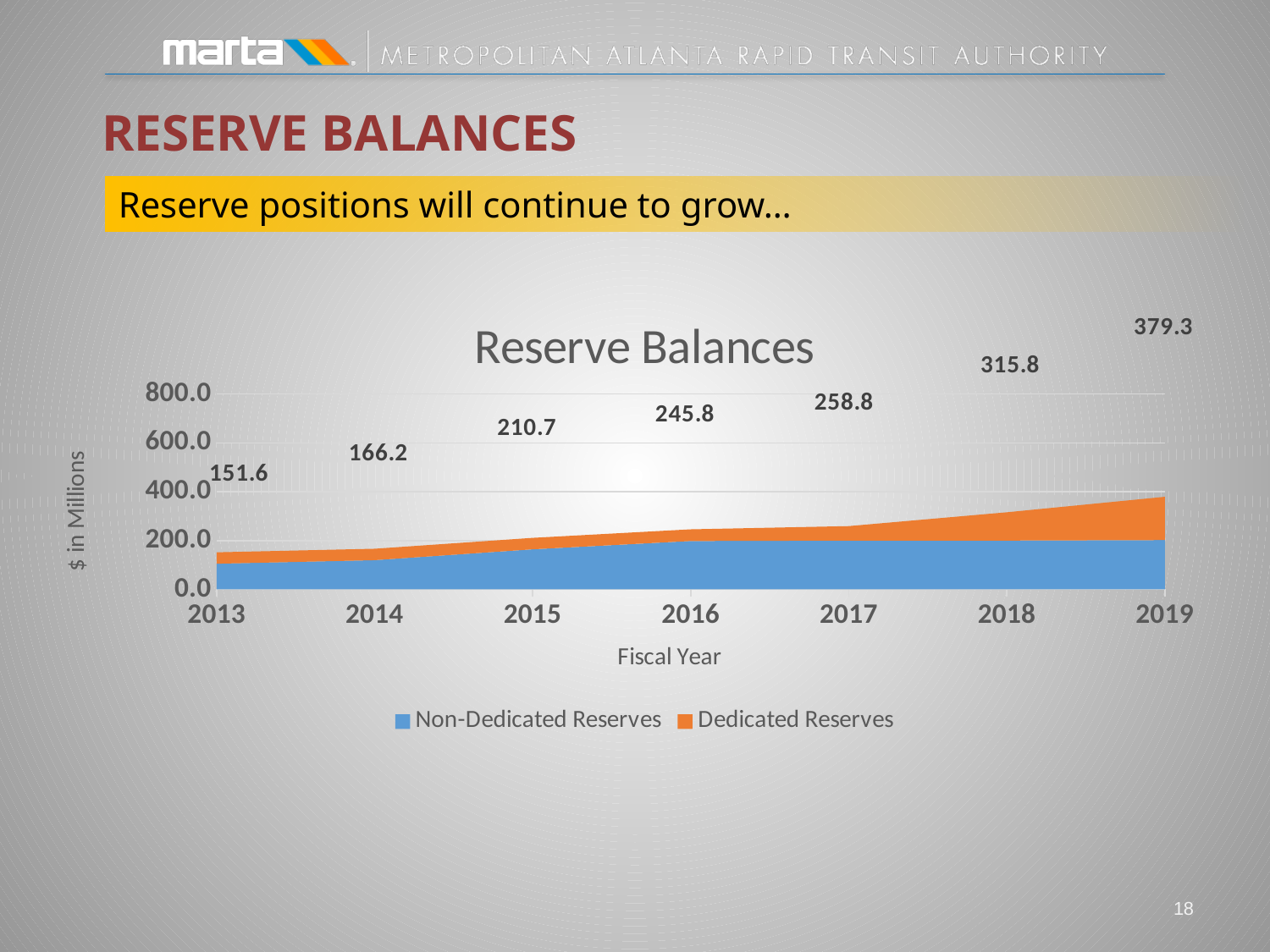
Is the value for Non-Dedicated Reserves in 2013 greater or less than 200.0? less How many fiscal years are plotted on the x axis? 7 Which fiscal year has a larger total reserve balance, 2017 or 2016? 2017 What is the difference between the total reserve balances for 2015 and 2014? 44.5 Do the total reserve balances rise or fall from 2013 to 2019? rise What is the difference between the total reserve balances for 2019 and 2018? 63.5 What is the total reserve balance shown for fiscal year 2013? 151.6 What is the total reserve balance shown for fiscal year 2019? 379.3 What is the total reserve balance shown for fiscal year 2016? 245.8 Which fiscal year has the lowest total reserve balance? 2013 How many series does the legend list? 2 Which fiscal year has the highest total reserve balance? 2019